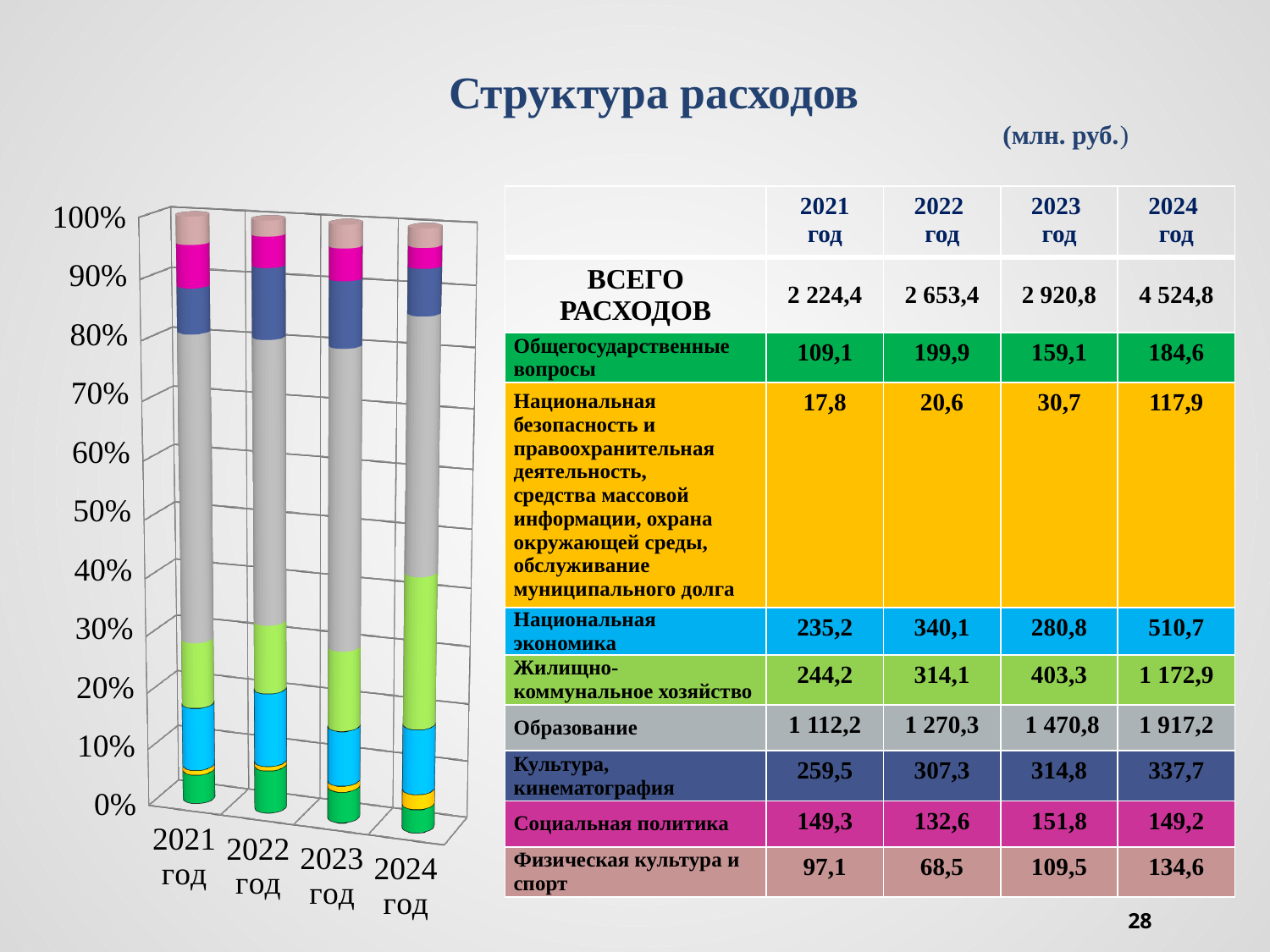
What is the difference between ВСЕГО РАСХОДОВ in 2024 год and 2021 год? 2 300,4 How many bars (years) does the chart show? 4 What is the value of ВСЕГО РАСХОДОВ for 2024 год? 4 524,8 What is the value for Жилищно-коммунальное хозяйство in 2024 год? 1 172,9 What is the value for Образование in 2022 год? 1 270,3 Which year has the lowest value for Физическая культура и спорт? 2022 год Which is larger: Национальная экономика in 2022 год or in 2023 год? 2022 год Which year has the highest total expenditure (ВСЕГО РАСХОДОВ)? 2024 год What kind of chart is shown on the left of the slide? Stacked bar chart How many expenditure categories (colour segments) are stacked in each bar, according to the table? 8 In the 2024 bar, is the top of the light green (Жилищно-коммунальное хозяйство) segment above or below the 30% line? above Does the total expenditure (ВСЕГО РАСХОДОВ) rise or fall from 2021 год to 2024 год? rise